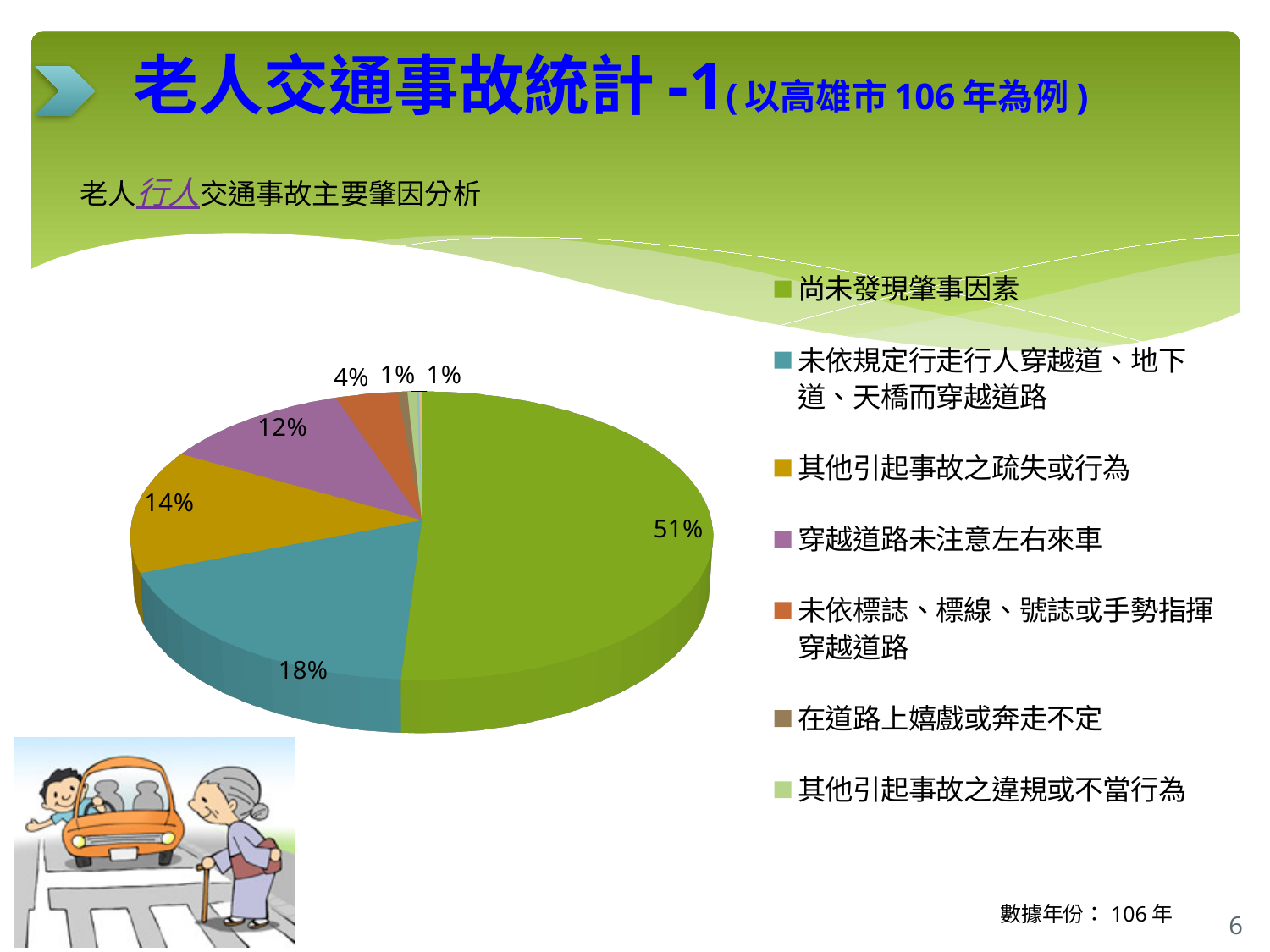
Which is larger, the share for 其他引起事故之疏失或行為 or the share for 穿越道路未注意左右來車? 其他引起事故之疏失或行為 What colour is the slice for 穿越道路未注意左右來車? purple How many categories does the legend list? 7 What share of the pie does 尚未發現肇事因素 account for? 51% Is the share for 尚未發現肇事因素 greater or less than 50%? greater Which category has the largest share of the pie? 尚未發現肇事因素 What is the value for 其他引起事故之疏失或行為? 14% What is the difference between the shares for 尚未發現肇事因素 and 未依規定行走行人穿越道、地下道、天橋而穿越道路? 33 percentage points What kind of chart is shown on the slide? pie chart What is the value for 未依標誌、標線、號誌或手勢指揮穿越道路? 4% What is the value for 穿越道路未注意左右來車? 12% What is the value for 未依規定行走行人穿越道、地下道、天橋而穿越道路? 18%